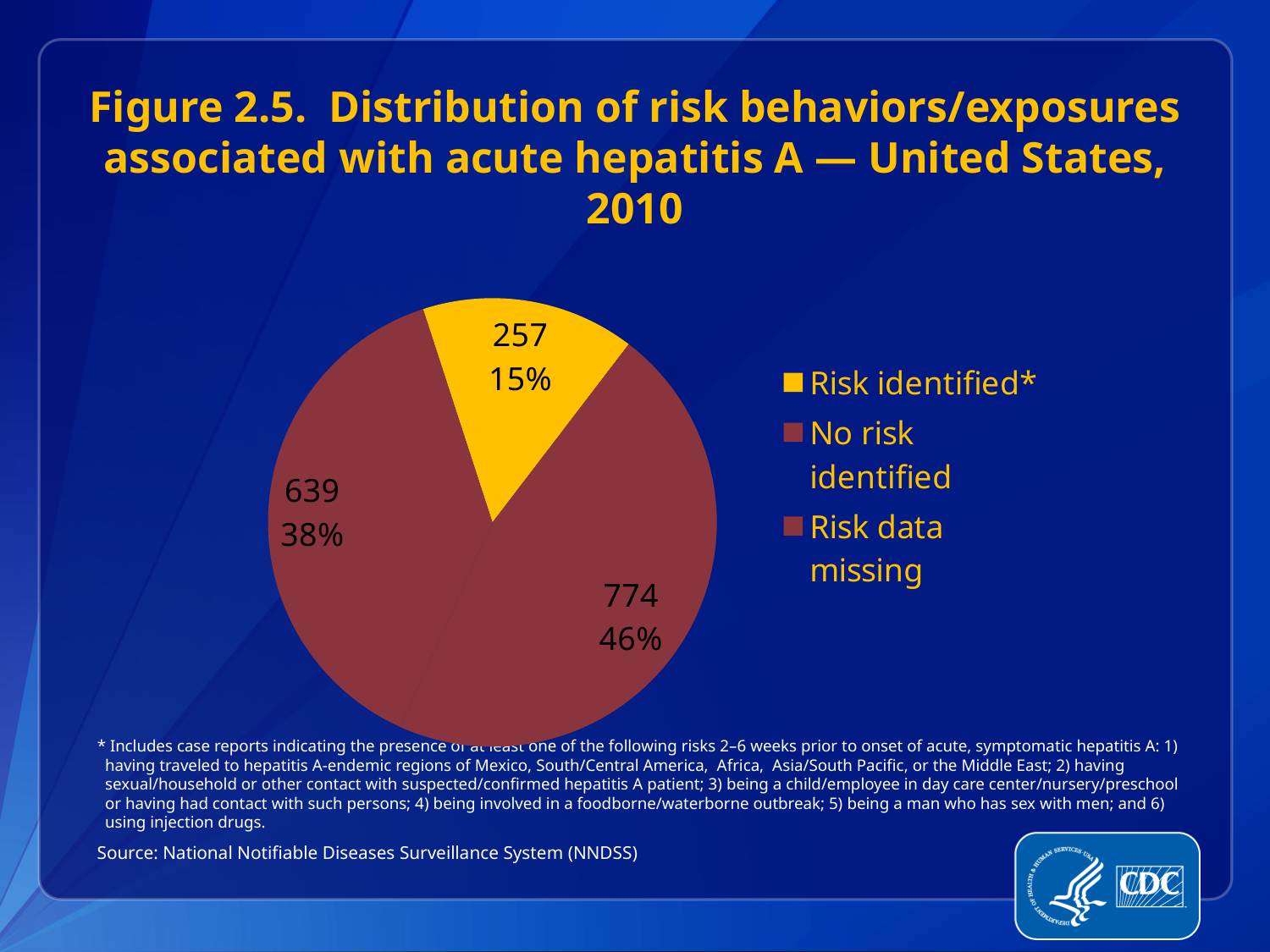
What is the value of the largest slice of the pie? 774 What percentage is shown on the largest slice of the pie? 46% What kind of chart is shown on the slide? pie chart What is the difference between the largest slice value (774) and the slice labeled 639? 135 How many entries does the legend list? 3 Which is larger, the slice labeled 774 or the Risk identified* slice labeled 257? 774 What colour is the Risk identified* slice? yellow What is the total of all three slice values shown on the pie? 1670 What is the number of cases in the Risk identified* slice? 257 What share of the pie does the Risk identified* slice represent? 15% What is the value of the smallest slice of the pie? 257 How many slices does the pie chart have? 3